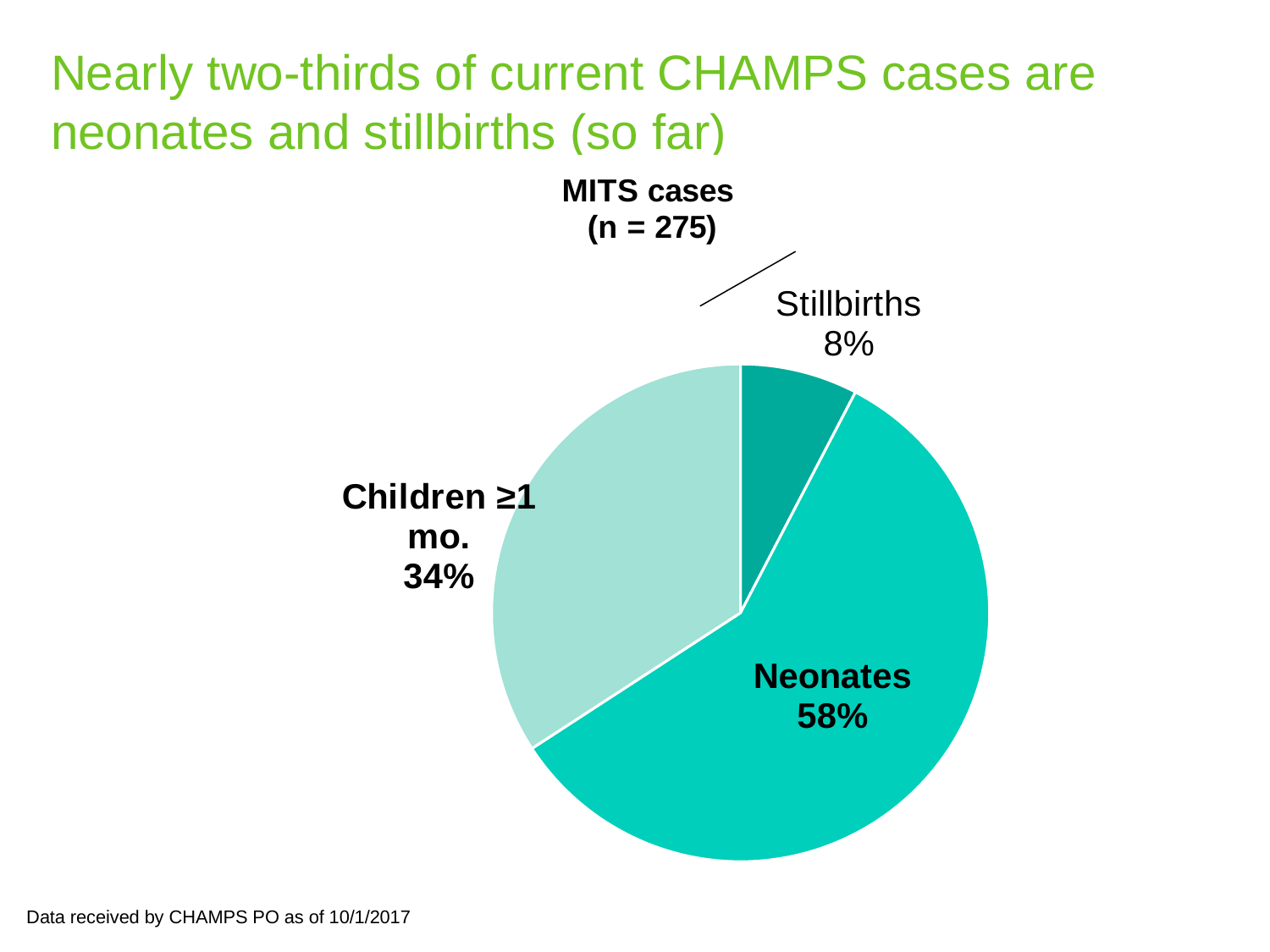
What share of MITS cases are Children ≥1 mo.? 34% Which category has the largest slice of the pie? Neonates What is the difference in percentage points between Neonates and Children ≥1 mo.? 24 How many slices does the pie chart have? 3 How many MITS cases does the chart title say are included? 275 What share of MITS cases are Neonates? 58% What share of MITS cases are Stillbirths? 8% What is the combined share of Neonates and Stillbirths? 66% Which is larger, the share for Children ≥1 mo. or the share for Stillbirths? Children ≥1 mo. What kind of chart is shown on the slide? pie chart What is the title of the pie chart? MITS cases (n = 275) Which category has the smallest slice of the pie? Stillbirths